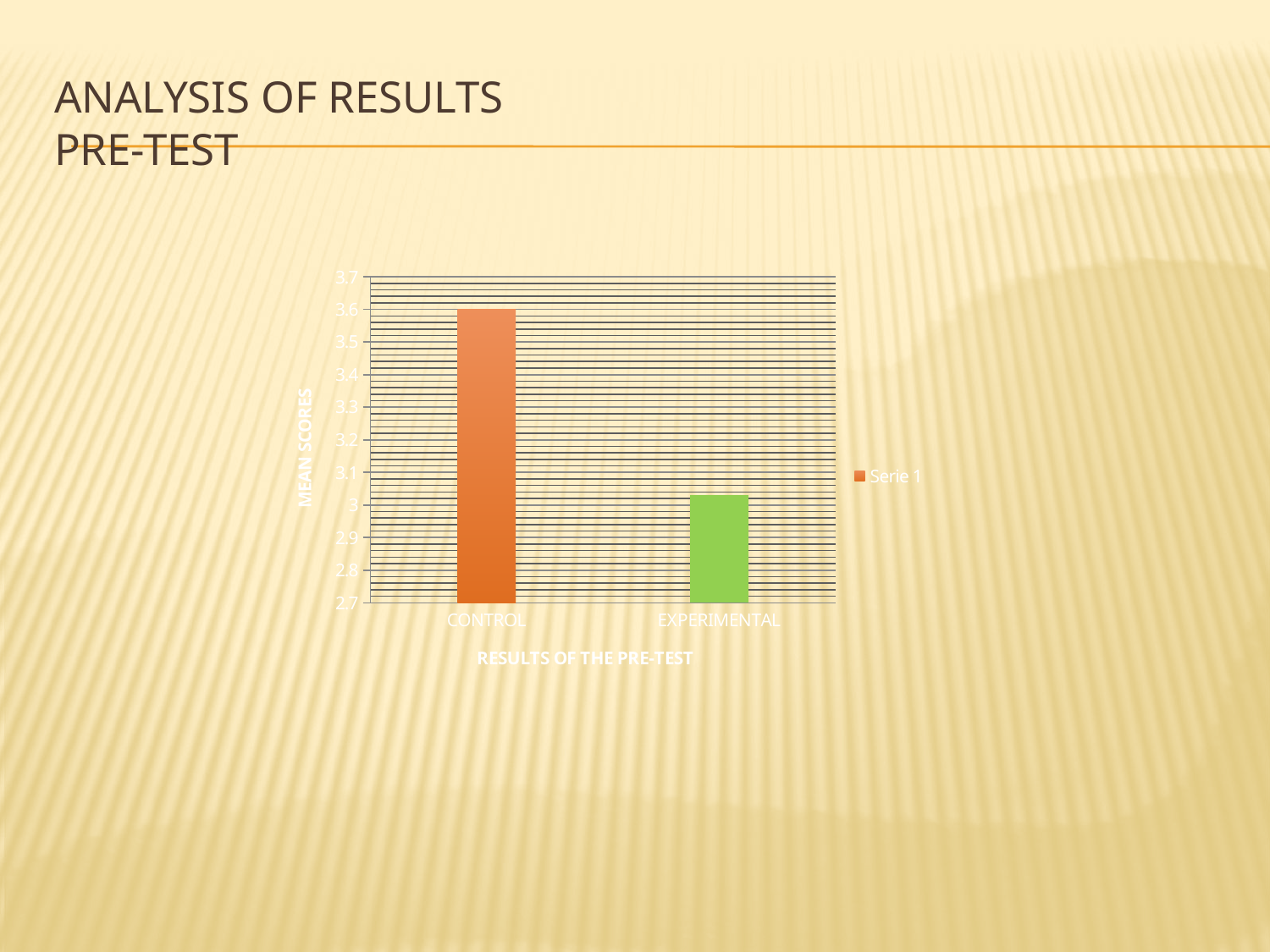
Which category has the lowest mean score? EXPERIMENTAL Which is larger, the mean score for CONTROL or for EXPERIMENTAL? CONTROL What is the name of the series listed in the legend? Serie 1 Which category has the highest mean score? CONTROL Is the value for CONTROL greater or less than 3.3? greater Is the value for EXPERIMENTAL greater or less than 3.1? less Is the value for EXPERIMENTAL greater or less than 3.5? less What is the mean score for CONTROL? 3.6 How many series does the legend list? 1 What is the label of the vertical axis? MEAN SCORES What kind of chart is shown on the slide? bar chart How many categories are shown on the x axis? 2